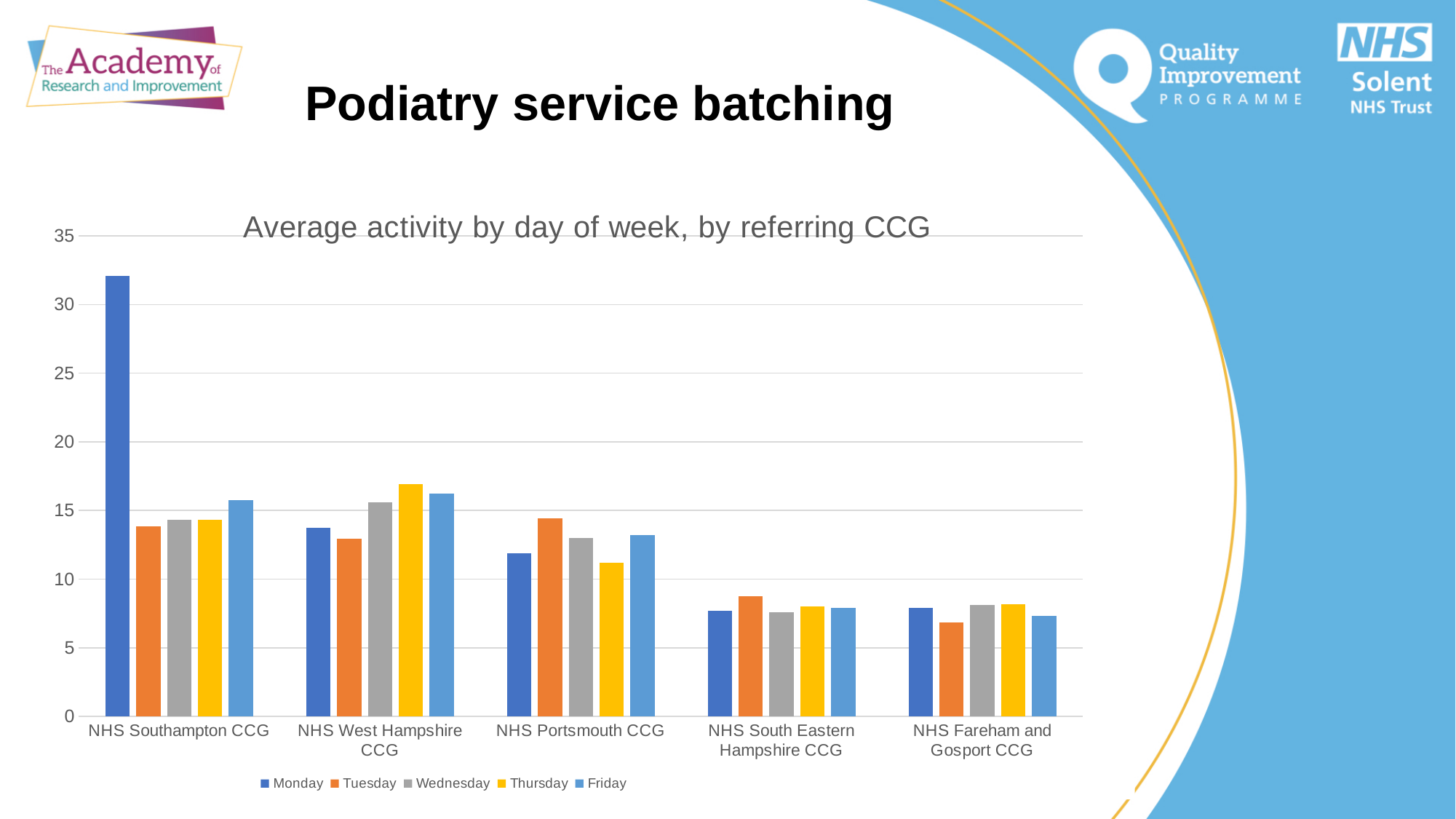
For NHS West Hampshire CCG, which day has the highest value? Thursday Which CCG has the highest Monday value? NHS Southampton CCG Is the Monday value for NHS Southampton CCG greater or less than 30? greater How many referring CCGs are shown on the x axis? 5 For NHS Fareham and Gosport CCG, which day has the lowest value? Tuesday Is the Monday value for NHS Portsmouth CCG greater or less than 10? greater For NHS Portsmouth CCG, which is larger, the Tuesday value or the Thursday value? Tuesday What kind of chart is shown on the slide? bar chart How many series does the legend list? 5 Is the Tuesday value for NHS Fareham and Gosport CCG greater or less than 10? less What is the title of the chart? Average activity by day of week, by referring CCG